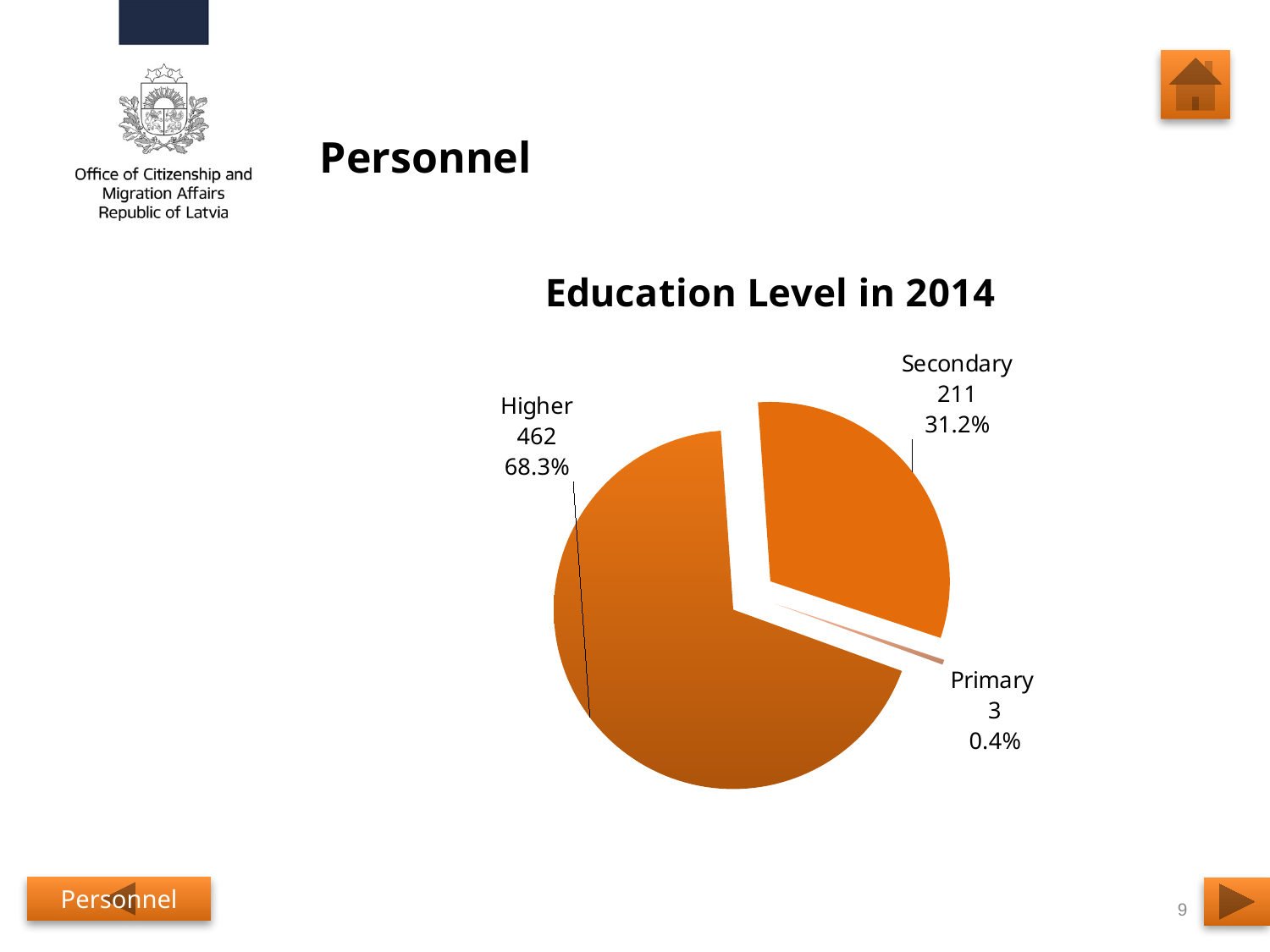
Which education level has the smallest slice? Primary How many slices does the pie chart have? 3 What is the value for Secondary? 211 What share of the pie does Primary represent? 0.4% What share of the pie does Higher represent? 68.3% What share of the pie does Secondary represent? 31.2% Which education level has the largest slice? Higher What kind of chart is shown on the slide? pie chart What is the difference between the values for Higher and Secondary? 251 What is the value for Higher? 462 What is the value for Primary? 3 What is the title of the chart? Education Level in 2014